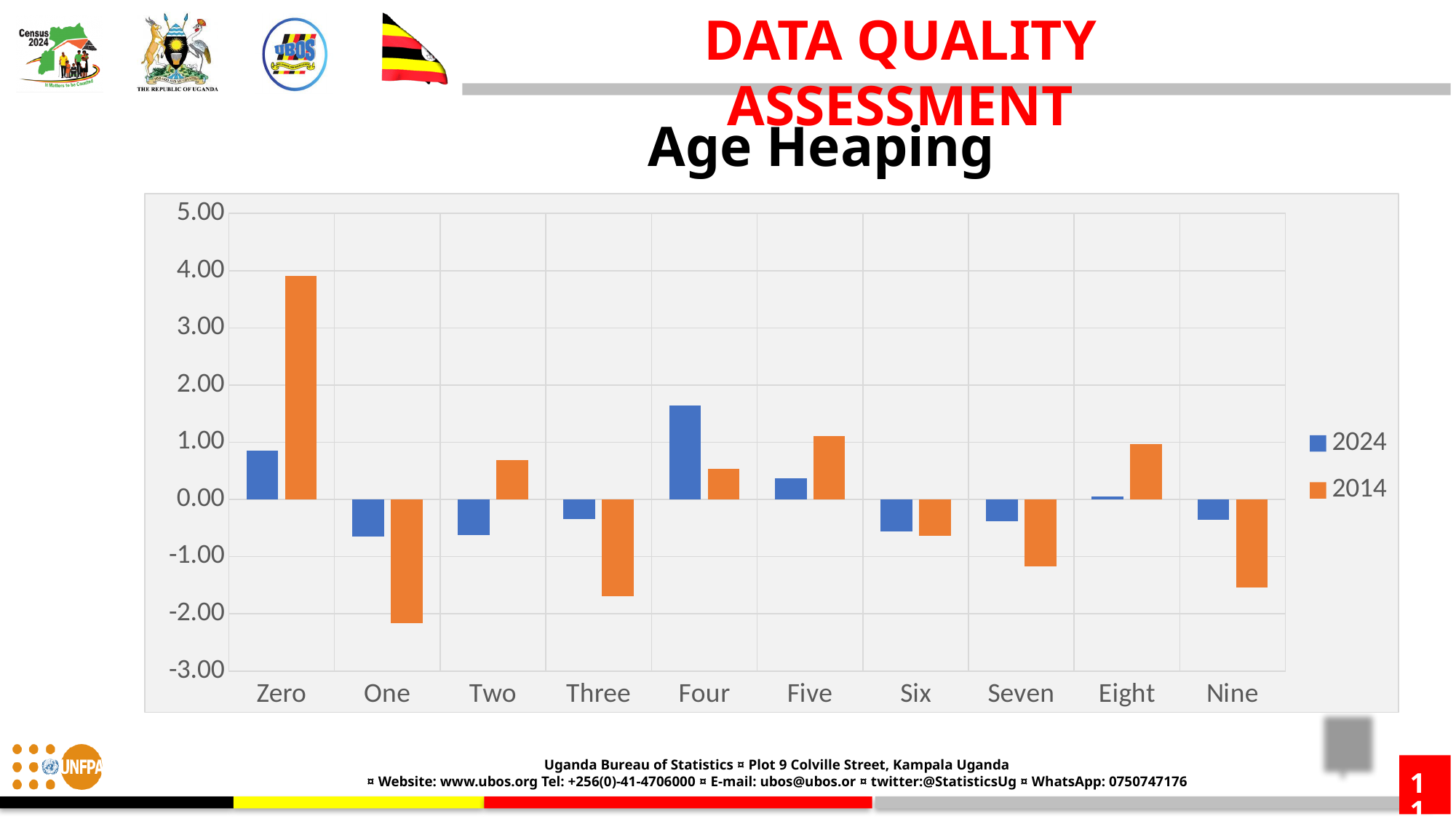
For the category Four, which series has the larger value, 2024 or 2014? 2024 Which category has the highest 2014 value in the Age Heaping chart? Zero Which category has the lowest 2014 value in the Age Heaping chart? One Is the 2024 value for Four greater or less than 1.00? greater Which category has the highest 2024 value in the Age Heaping chart? Four What are the two series named in the legend of the Age Heaping chart? 2024 and 2014 Is the 2014 value for Zero greater or less than 3.00? greater How many series does the legend of the Age Heaping chart list? 2 For the category Five, which series has the larger value, 2024 or 2014? 2014 How many categories are shown along the x axis of the Age Heaping chart? 10 Is the 2014 value for One greater or less than -2.00? less What kind of chart is shown on the Age Heaping slide? bar chart